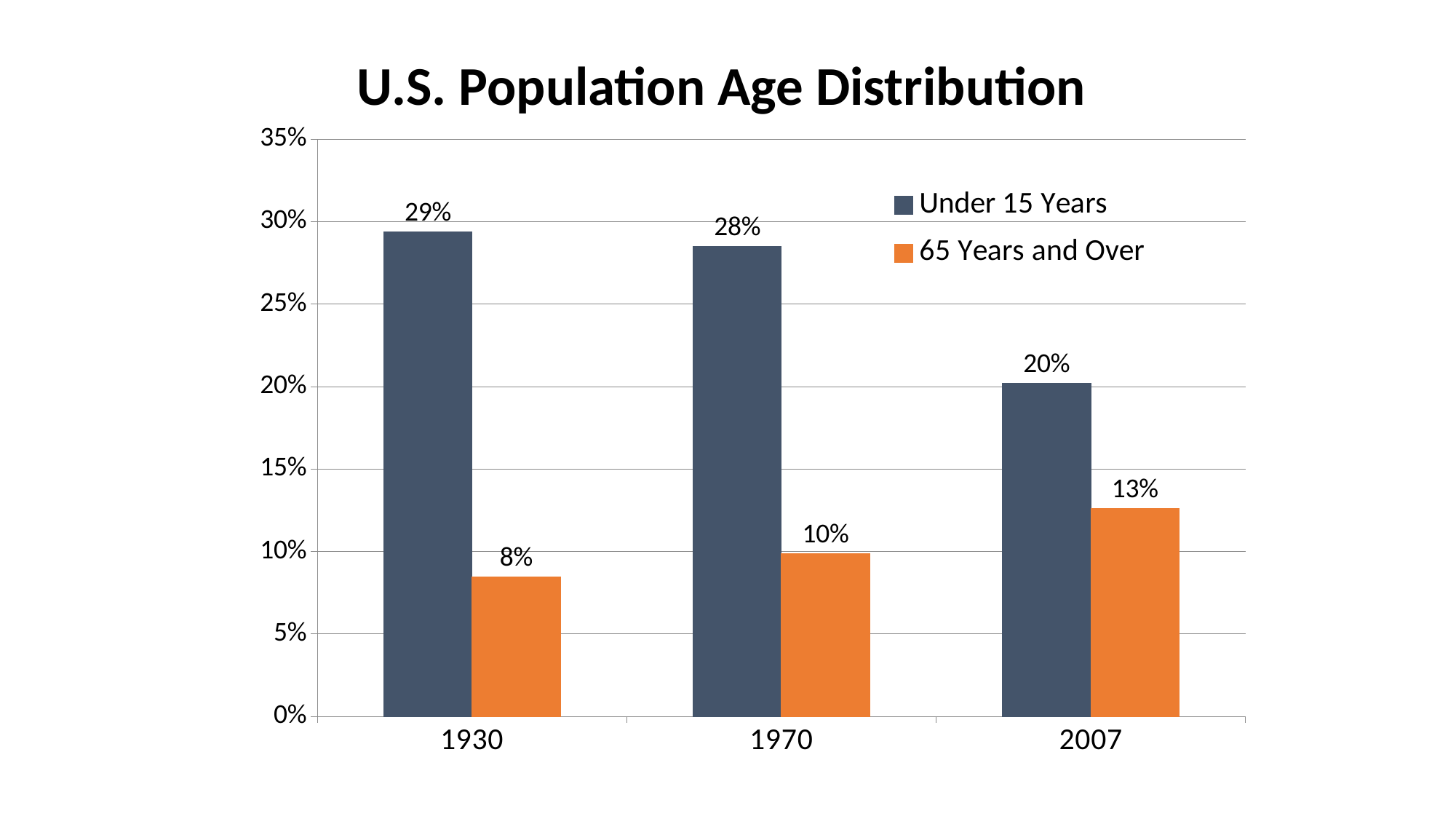
In which year is the 65 Years and Over value highest? 2007 How many series does the legend list? 2 What is the value for Under 15 Years in 1930? 29% What is the difference between the Under 15 Years and 65 Years and Over values in 1930? 21% In which year is the Under 15 Years value lowest? 2007 What is the value for 65 Years and Over in 1970? 10% What kind of chart is shown? Bar chart Which is larger in 2007: Under 15 Years or 65 Years and Over? Under 15 Years How many years are shown on the x axis? 3 Is the value for Under 15 Years in 1970 greater or less than 25%? greater Does the Under 15 Years value rise or fall from 1930 to 2007? Fall What is the value for 65 Years and Over in 2007? 13%